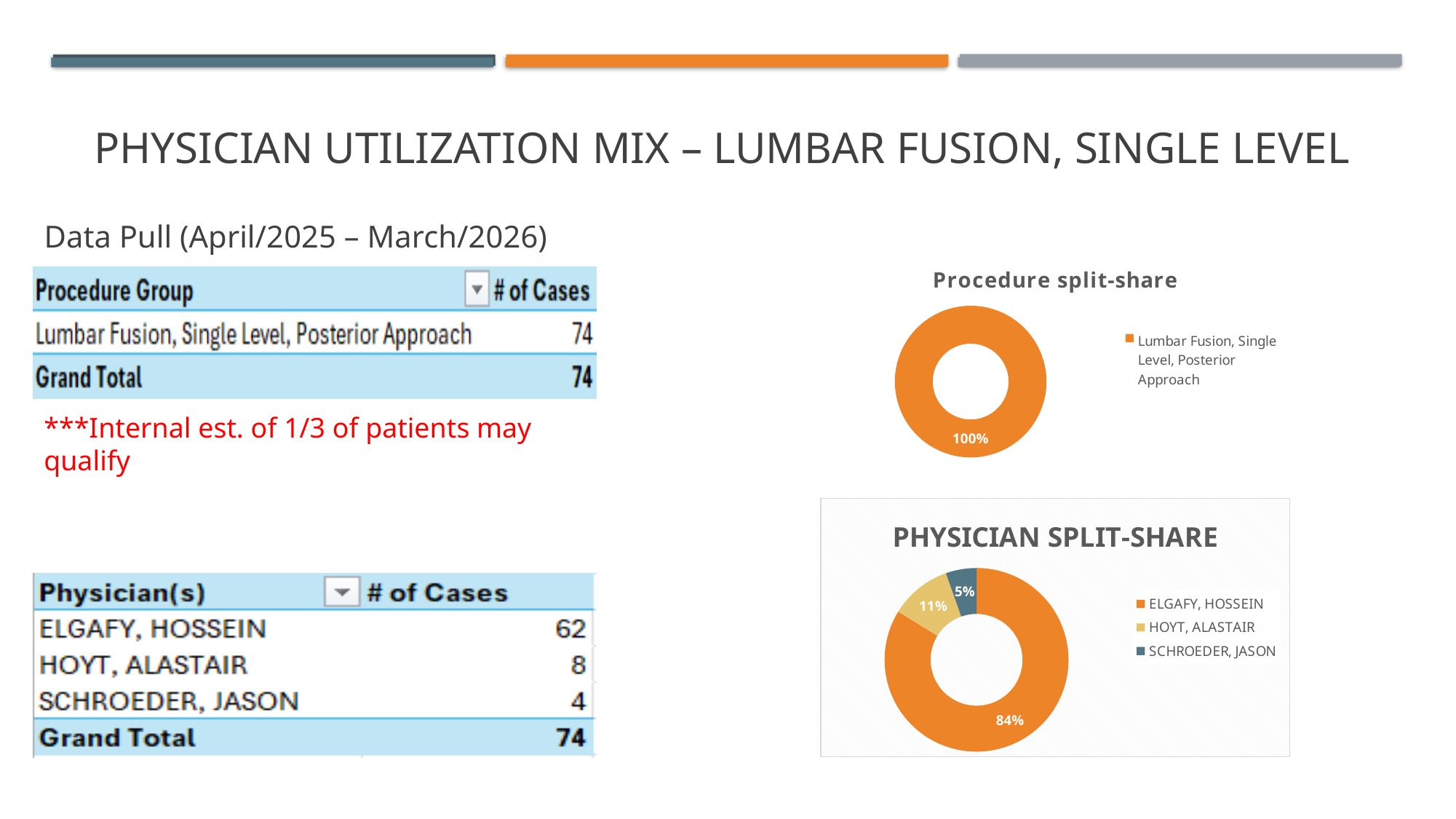
In the Physician split-share chart, what share is shown for SCHROEDER, JASON? 5% In the Procedure split-share chart, what share is shown for Lumbar Fusion, Single Level, Posterior Approach? 100% In the Physician split-share chart, which physician has the smallest share? SCHROEDER, JASON In the Physician split-share chart, what is the difference in percentage points between the shares of ELGAFY, HOSSEIN and HOYT, ALASTAIR? 73 In the Physician split-share chart, how many physicians does the legend list? 3 In the Physician split-share chart, which physician has the largest share? ELGAFY, HOSSEIN In the Physician split-share chart, what share is shown for HOYT, ALASTAIR? 11% In the Physician split-share chart, which has the larger share, HOYT, ALASTAIR or SCHROEDER, JASON? HOYT, ALASTAIR In the Procedure split-share chart, how many categories does the legend list? 1 In the Physician split-share chart, what colour is the slice for SCHROEDER, JASON? Dark blue-grey What kind of chart is the Physician split-share chart? Doughnut chart